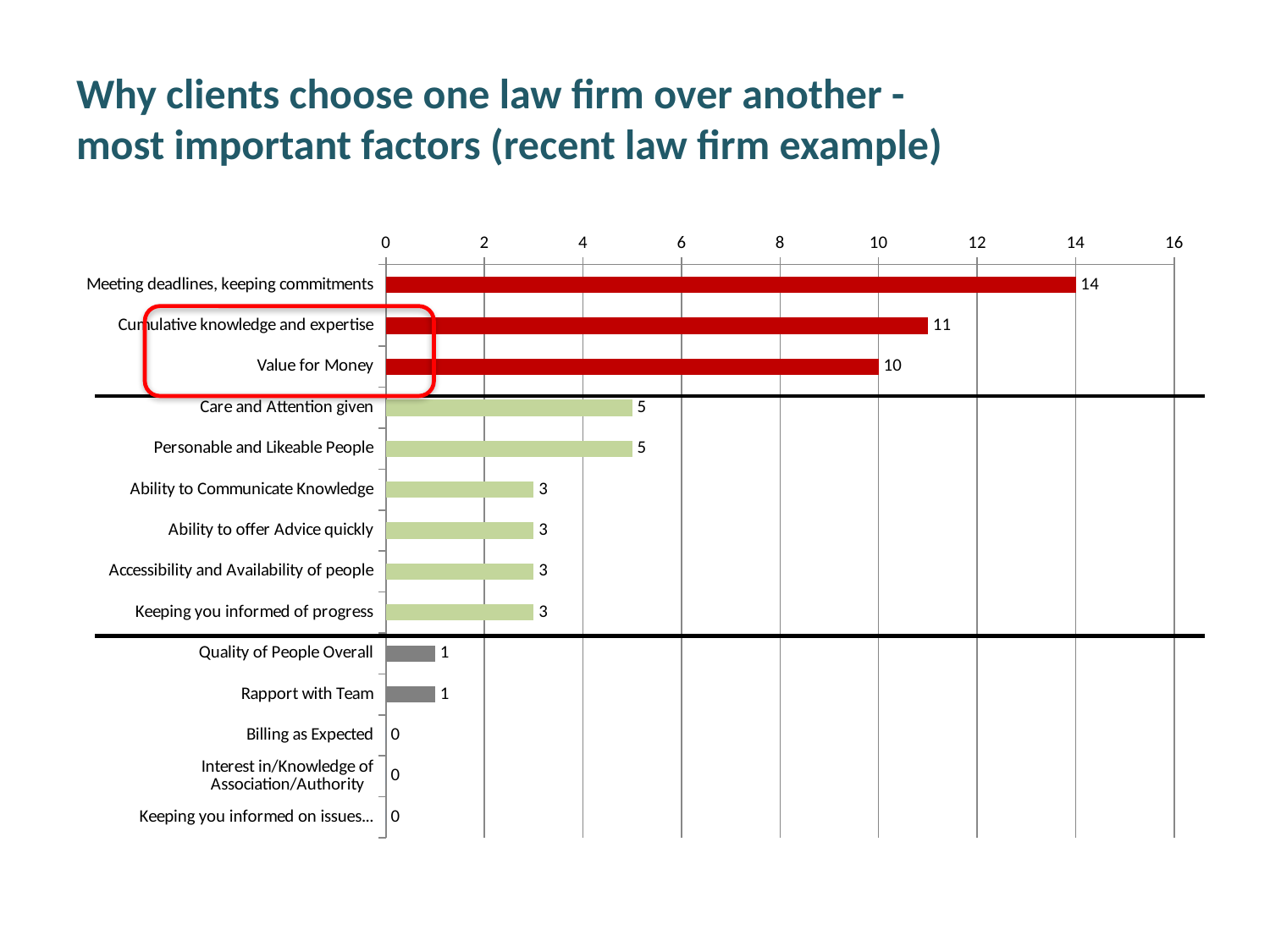
Is the value for Meeting deadlines, keeping commitments greater or less than 12? greater Which category has the highest value? Meeting deadlines, keeping commitments What is the value for Value for Money? 10 What kind of chart is shown on the slide? Bar chart How many categories are shown on the chart? 14 What is the value for Meeting deadlines, keeping commitments? 14 What is the value for Cumulative knowledge and expertise? 11 Which is larger, the value for Cumulative knowledge and expertise or the value for Personable and Likeable People? Cumulative knowledge and expertise What is the difference between the values for Meeting deadlines, keeping commitments and Value for Money? 4 What is the value for Rapport with Team? 1 What is the value for Billing as Expected? 0 What is the value for Care and Attention given? 5